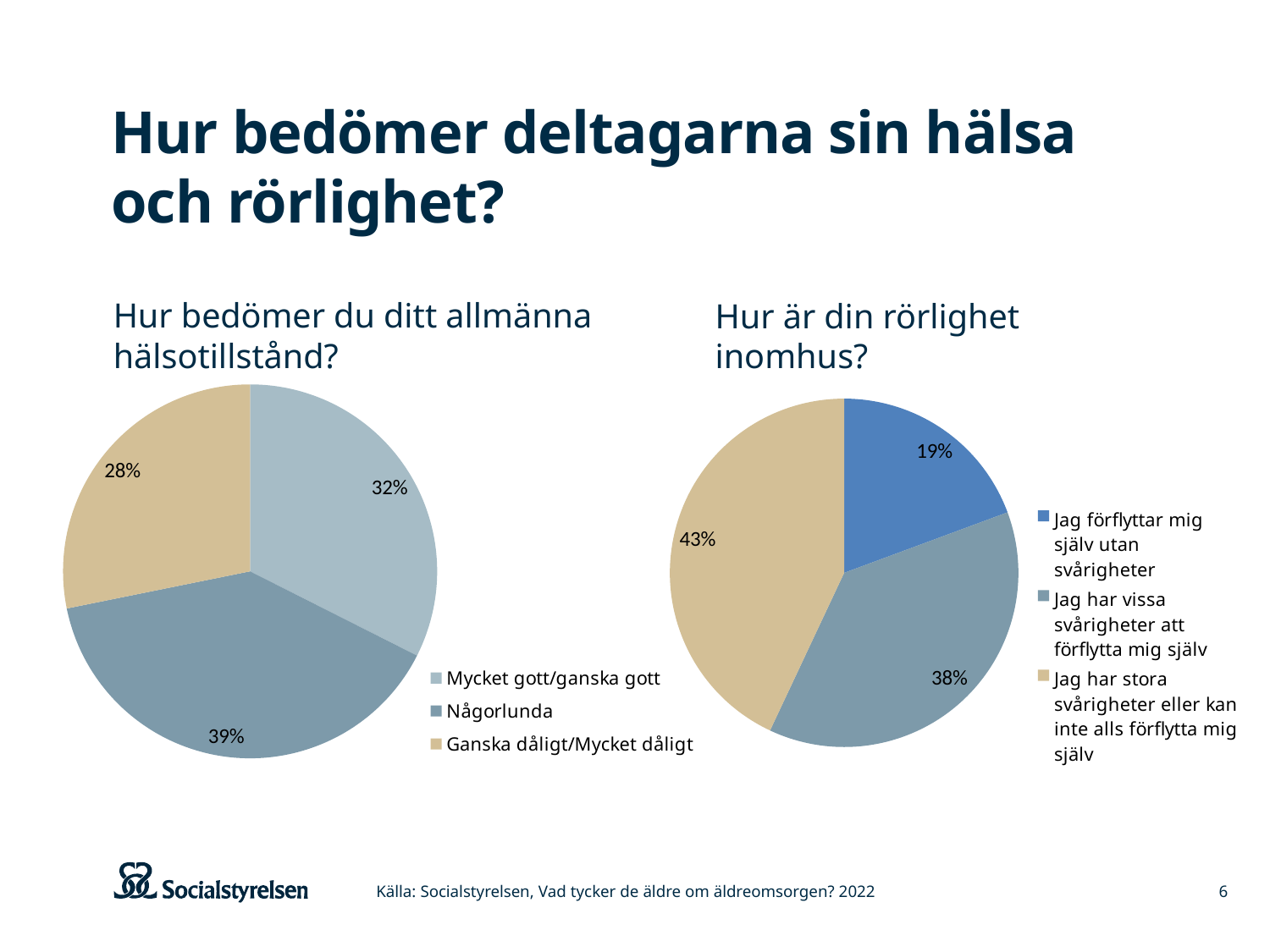
In the chart 'Hur är din rörlighet inomhus?', what is the difference in percentage points between the largest and smallest slices? 24 percentage points In the chart 'Hur bedömer du ditt allmänna hälsotillstånd?', what is the difference in percentage points between 'Någorlunda' and 'Ganska dåligt/Mycket dåligt'? 11 percentage points In the chart 'Hur är din rörlighet inomhus?', what share of respondents answered 'Jag har stora svårigheter eller kan inte alls förflytta mig själv'? 43% In the chart 'Hur är din rörlighet inomhus?', which category has the largest share? Jag har stora svårigheter eller kan inte alls förflytta mig själv How many slices does the chart 'Hur är din rörlighet inomhus?' have? 3 What type of chart is used for 'Hur bedömer du ditt allmänna hälsotillstånd?'? Pie chart In the chart 'Hur är din rörlighet inomhus?', what share of respondents answered 'Jag förflyttar mig själv utan svårigheter'? 19% In the chart 'Hur bedömer du ditt allmänna hälsotillstånd?', which category has the smallest share? Ganska dåligt/Mycket dåligt In the chart 'Hur är din rörlighet inomhus?', which is larger: 'Jag har vissa svårigheter att förflytta mig själv' or 'Jag förflyttar mig själv utan svårigheter'? Jag har vissa svårigheter att förflytta mig själv In the chart 'Hur bedömer du ditt allmänna hälsotillstånd?', what share of respondents answered 'Mycket gott/ganska gott'? 32% In the chart 'Hur bedömer du ditt allmänna hälsotillstånd?', what share of respondents answered 'Någorlunda'? 39% In the chart 'Hur bedömer du ditt allmänna hälsotillstånd?', which category has the largest share? Någorlunda